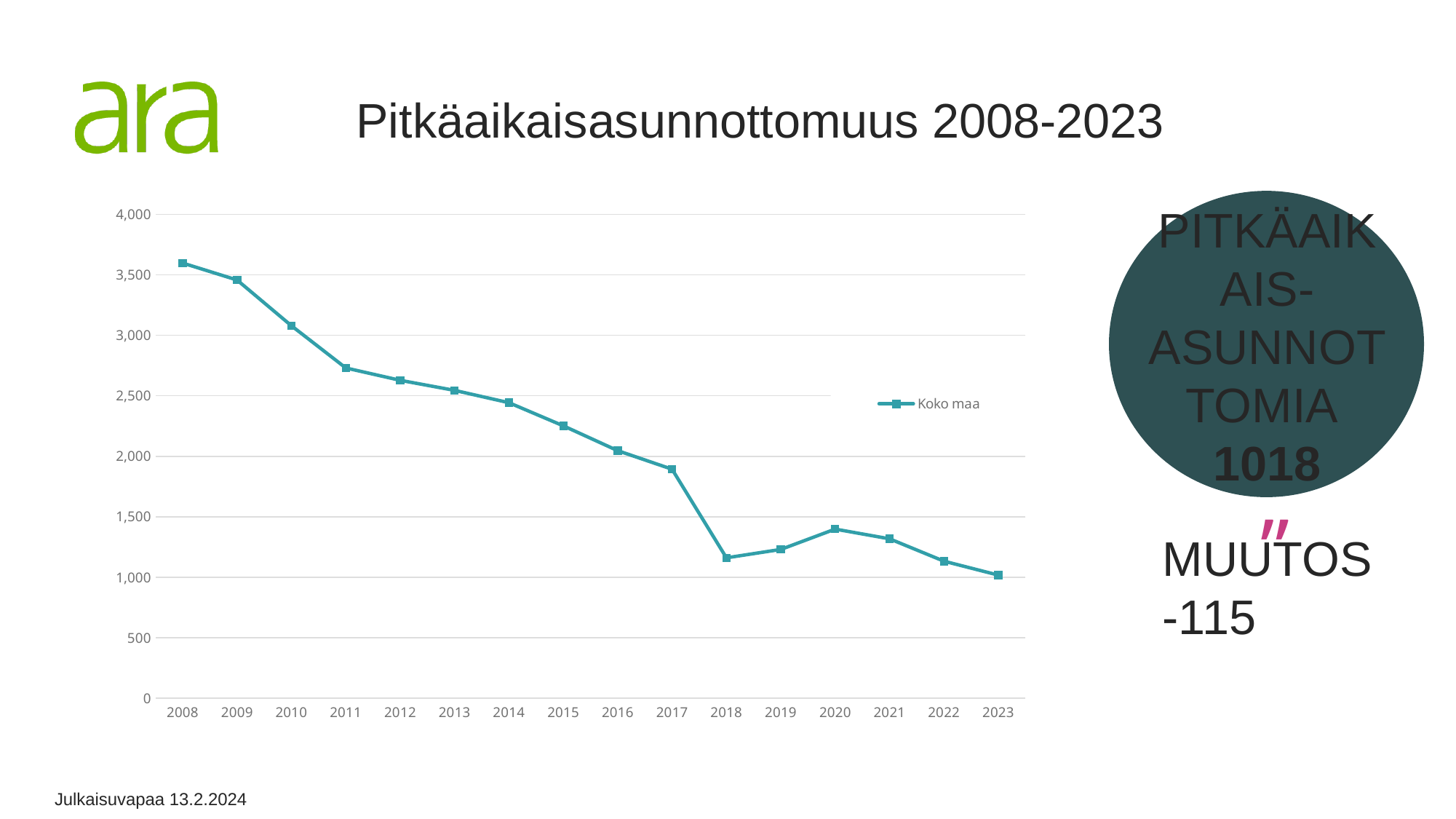
Which year has the larger value, 2019 or 2020? 2020 Is the value for 2008 greater or less than 3,500? greater What is the name of the series shown in the legend? Koko maa Do the values generally rise or fall from 2008 to 2023? fall In which year is the value highest? 2008 What is the title of the chart? Pitkäaikaisasunnottomuus 2008-2023 Is the value for 2017 greater or less than 2,000? less How many series does the legend list? 1 In which year is the value lowest? 2023 Is the value for 2020 greater or less than 1,500? less What kind of chart is shown on the slide? line chart How many years (data points) are plotted on the x axis? 16